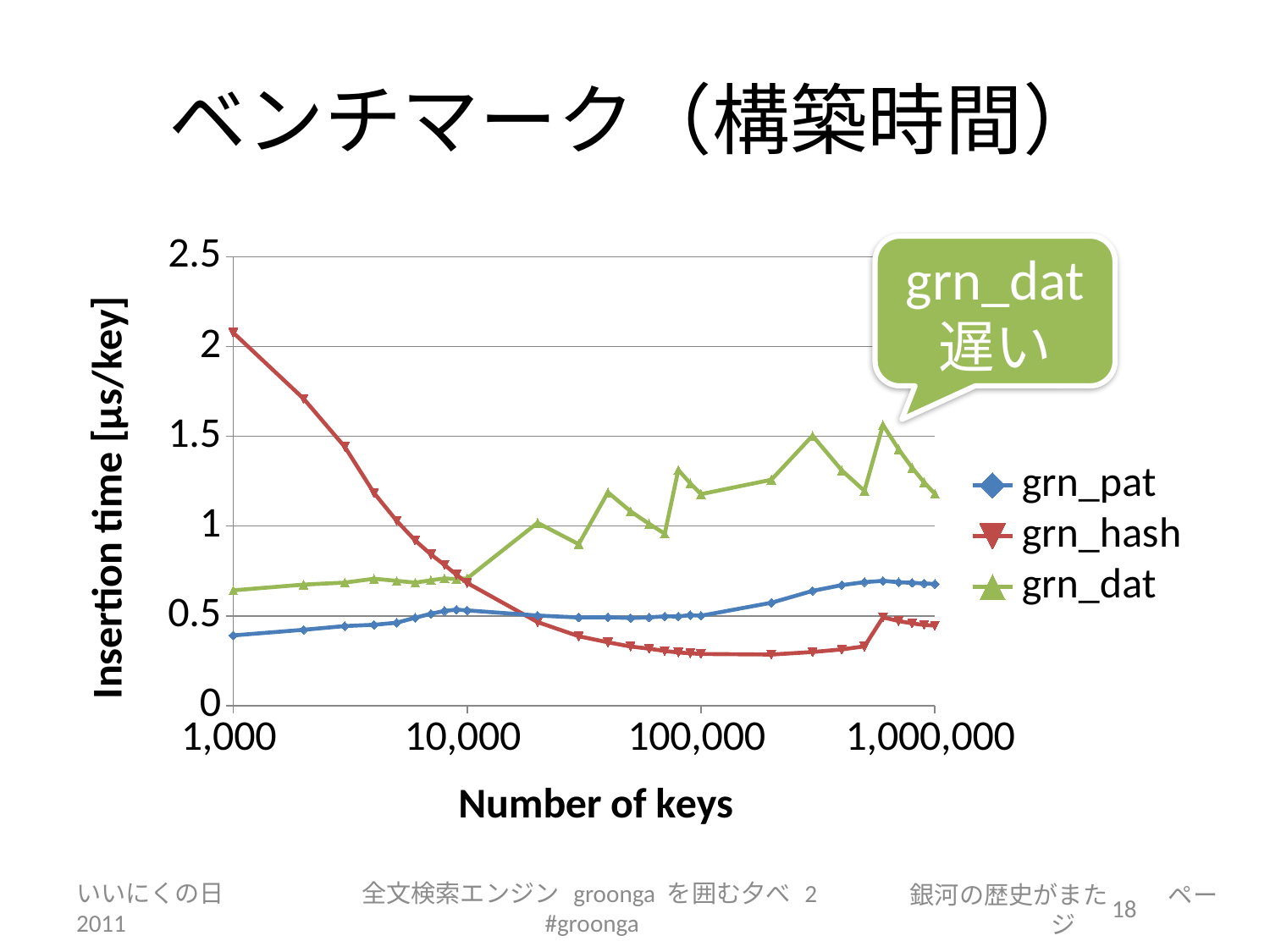
Which series has the lowest insertion time at 1,000,000 keys? grn_hash Is the value for grn_hash at 1,000 keys greater or less than 1.5? greater How many series does the legend list? 3 Is the value for grn_dat at 1,000 keys greater or less than 1? less Which series has the highest insertion time at 1,000,000 keys? grn_dat At 1,000,000 keys, which series has the larger insertion time, grn_dat or grn_hash? grn_dat What kind of chart is shown on the slide? line chart Is the value for grn_pat at 1,000,000 keys greater or less than 1? less What is the title of the vertical axis? Insertion time [μs/key] At 1,000 keys, which series has the larger insertion time, grn_hash or grn_pat? grn_hash What is the title of the horizontal axis? Number of keys Does the grn_hash line rise or fall as the number of keys increases from 1,000 to 100,000? fall